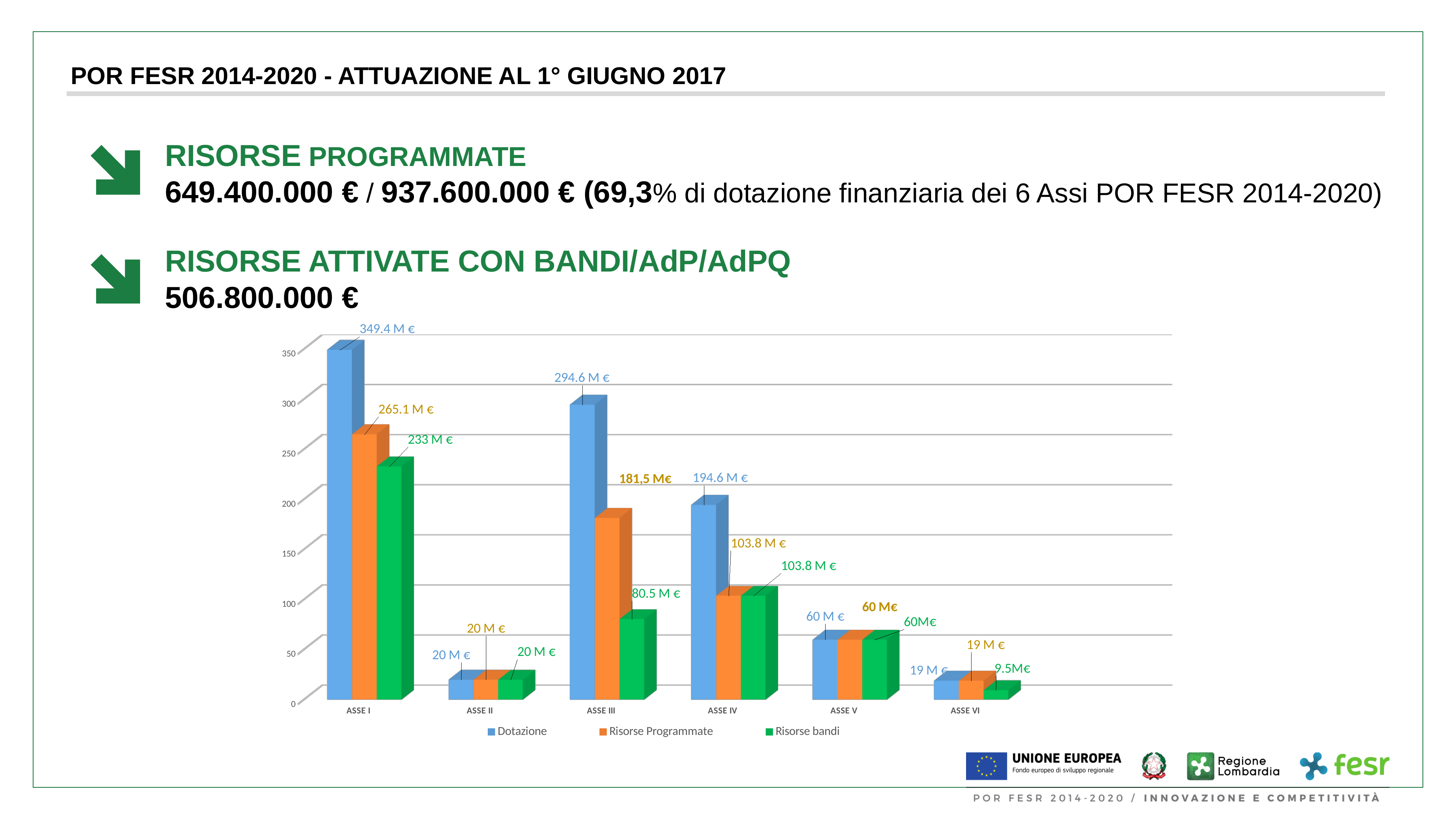
Which category has the highest Dotazione value? ASSE I What kind of chart is shown on the slide? Bar chart What is the Risorse Programmate value for ASSE III? 181,5 M€ Which category has the lowest Dotazione value? ASSE VI Which series is shown in green in the legend? Risorse bandi How many series does the legend list? 3 What is the Risorse bandi value for ASSE III? 80.5 M € What is the Dotazione value for ASSE I? 349.4 M € What is the Risorse bandi value for ASSE VI? 9.5M€ Which is larger for ASSE IV: the Dotazione value or the Risorse Programmate value? Dotazione How many categories are shown on the x axis? 6 What is the difference between the Dotazione and Risorse bandi values for ASSE I? 116.4 M €